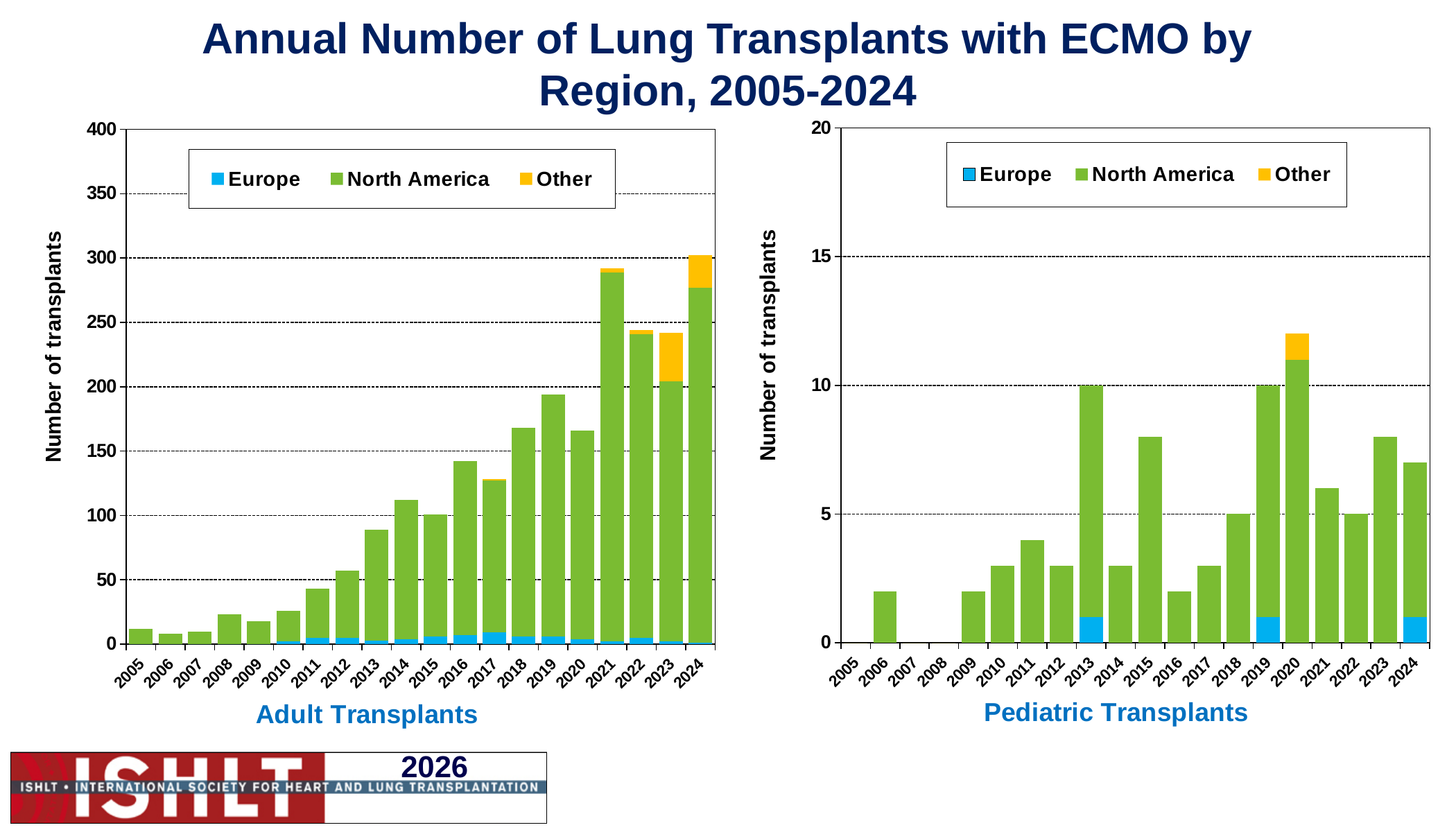
In the Pediatric Transplants chart, what is the total number of transplants in 2013? 10 In the Adult Transplants chart, is the total value for 2021 greater or less than 250? greater In the Adult Transplants chart, do the total values generally rise or fall from 2005 to 2024? rise In the Adult Transplants chart, is the total value for 2005 greater or less than 50? less In the Adult Transplants chart, is the total value for 2019 greater or less than 150? greater In the Pediatric Transplants chart, what is the total number of transplants in 2018? 5 What kind of chart is the Adult Transplants chart? bar chart How many series does the legend of the Pediatric Transplants chart list? 3 In the Pediatric Transplants chart, which year has the highest total number of transplants? 2020 Which region is shown in yellow in the legend of the Adult Transplants chart? Other How many years are shown on the x axis of the Adult Transplants chart? 20 In the Adult Transplants chart, which year has the larger total, 2020 or 2021? 2021